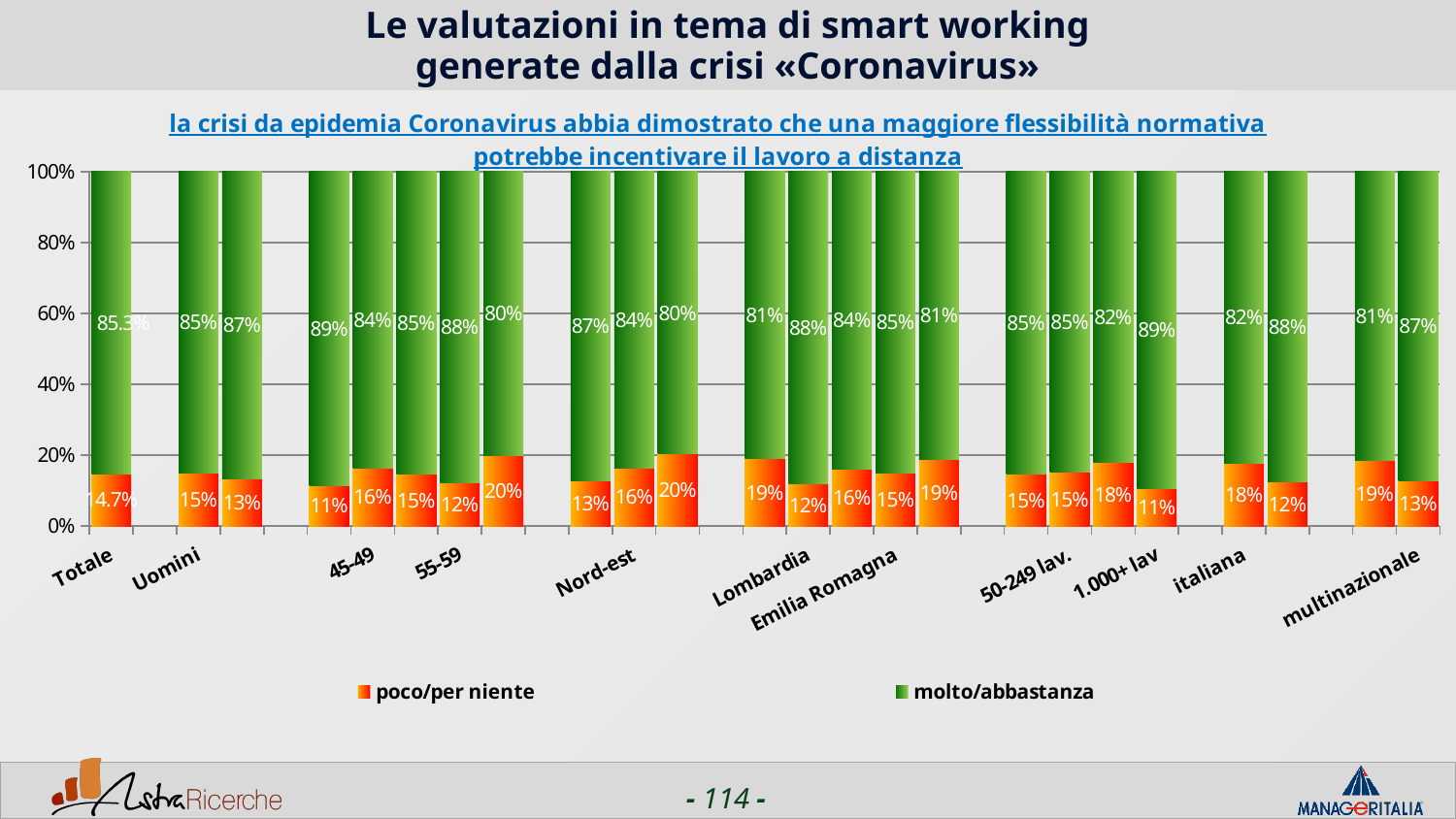
Which has the larger 'poco/per niente' value, italiana or multinazionale? italiana How many series does the chart legend list? 2 What is the 'molto/abbastanza' value for Lombardia? 88% What is the 'poco/per niente' value for 1.000+ lav? 11% What is the difference between the 'molto/abbastanza' values for 1.000+ lav and 50-249 lav.? 4 percentage points What is the 'molto/abbastanza' value for Totale? 85.3% What is the 'poco/per niente' value for Nord-est? 16% What is the 'poco/per niente' value for the 45-49 group? 16% What is the 'poco/per niente' value for Totale? 14.7% What is the 'molto/abbastanza' value for Uomini? 85% What kind of chart is shown on the slide? Stacked bar chart What is the 'molto/abbastanza' value for the 55-59 group? 88%